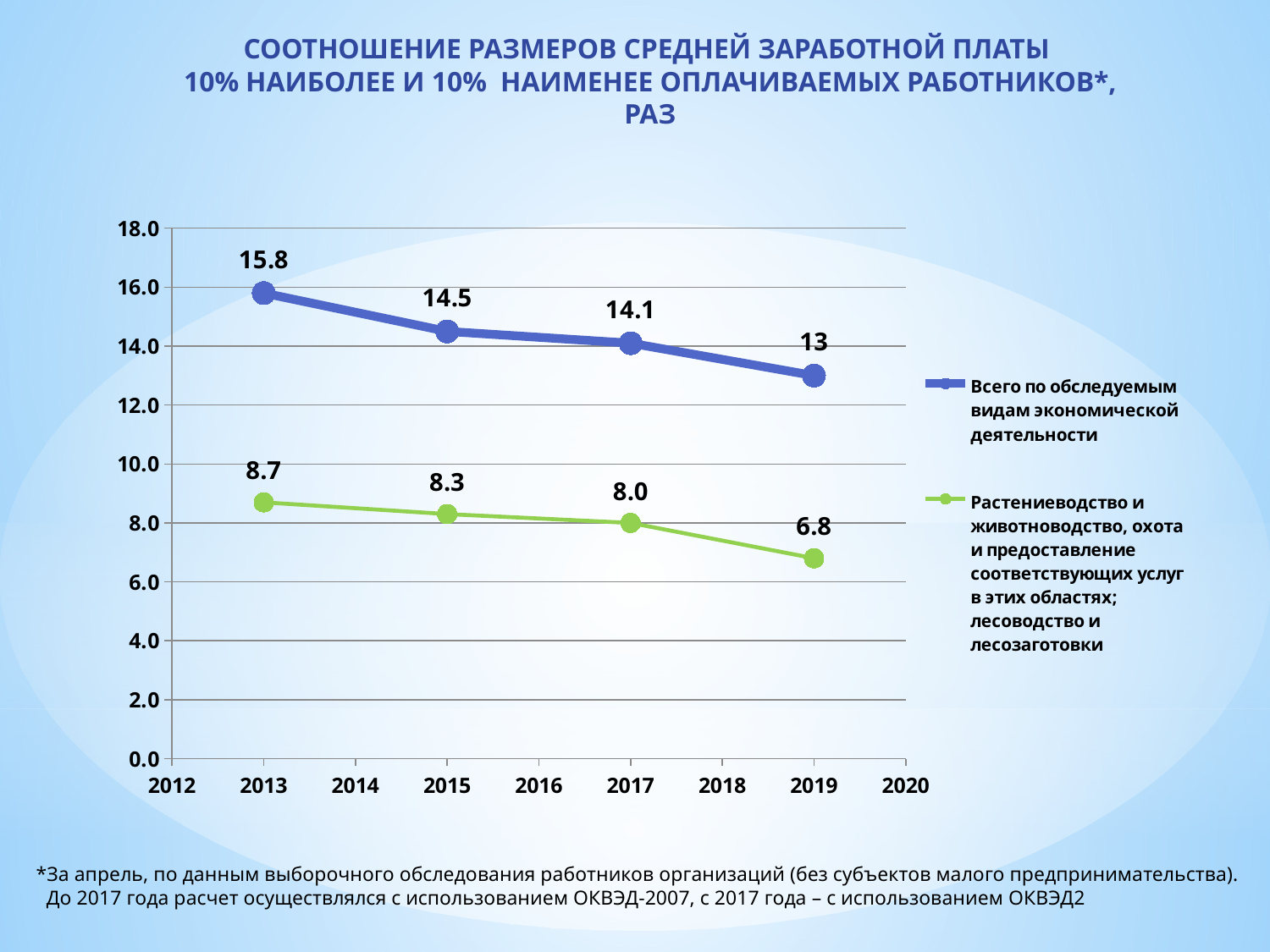
How many series does the legend list? 2 Do the values for "Растениеводство и животноводство..." rise or fall from 2013 to 2019? Fall In which year is the value for "Всего по обследуемым видам экономической деятельности" highest? 2013 In which year is the value for "Растениеводство и животноводство..." lowest? 2019 What is the difference between the two series' values in 2015? 6.2 Which series has the larger value in 2019? Всего по обследуемым видам экономической деятельности What is the value for "Всего по обследуемым видам экономической деятельности" in 2013? 15.8 What is the value for "Растениеводство и животноводство, охота и предоставление соответствующих услуг в этих областях; лесоводство и лесозаготовки" in 2019? 6.8 What kind of chart is shown on the slide? Line chart What is the value for "Всего по обследуемым видам экономической деятельности" in 2017? 14.1 By how much did the value for "Всего по обследуемым видам экономической деятельности" fall from 2013 to 2019? 2.8 How many data points are plotted for each series? 4